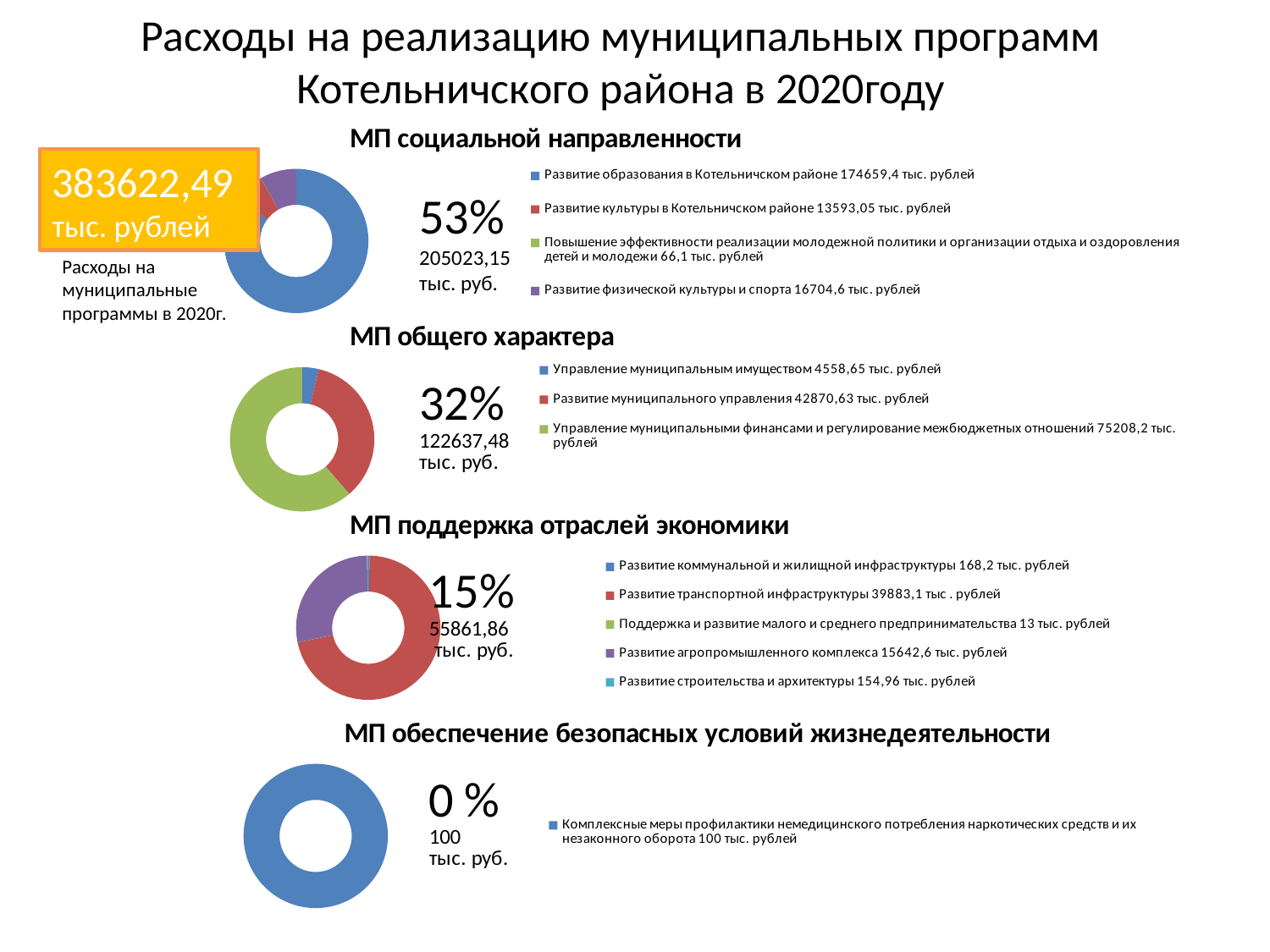
In the chart 'МП социальной направленности', what is the value for 'Развитие образования в Котельничском районе'? 174659,4 тыс. рублей What kind of chart is used for 'МП обеспечение безопасных условий жизнедеятельности'? Donut (pie) chart In the chart 'МП общего характера', which is larger: 'Управление муниципальным имуществом' or 'Развитие муниципального управления'? Развитие муниципального управления In the chart 'МП поддержка отраслей экономики', which category has the largest value? Развитие транспортной инфраструктуры In the chart 'МП поддержка отраслей экономики', how many categories does the legend list? 5 In the chart 'МП общего характера', what is the value for 'Развитие муниципального управления'? 42870,63 тыс. рублей In the chart 'МП поддержка отраслей экономики', what is the difference between 'Развитие коммунальной и жилищной инфраструктуры' and 'Развитие строительства и архитектуры'? 13,24 тыс. рублей What percentage is shown next to the chart 'МП общего характера'? 32% In the chart 'МП социальной направленности', which category has the smallest value? Повышение эффективности реализации молодежной политики и организации отдыха и оздоровления детей и молодежи In the chart 'МП поддержка отраслей экономики', what is the value for 'Развитие агропромышленного комплекса'? 15642,6 тыс. рублей In the chart 'МП социальной направленности', how many categories does the legend list? 4 In the chart 'МП общего характера', which category has the largest value? Управление муниципальными финансами и регулирование межбюджетных отношений